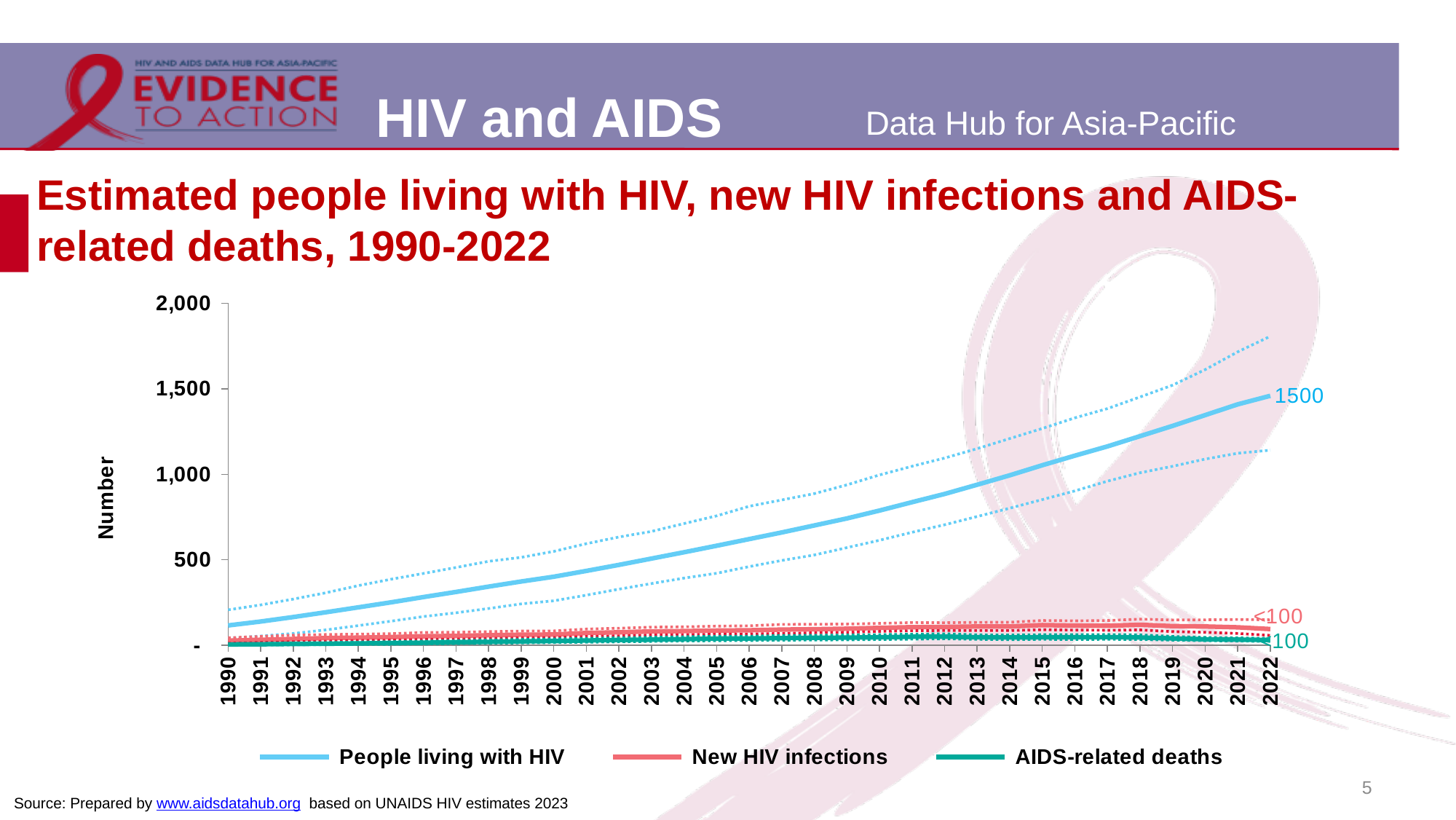
Which is larger in 2022, People living with HIV or AIDS-related deaths? People living with HIV Does the People living with HIV line rise or fall from 1990 to 2022? rise What is the value for People living with HIV in 2022? 1500 Is the value for People living with HIV in 1995 greater or less than 500? less How many series does the legend list? 3 What is the label on the y axis? Number Which series has the highest value in 2022? People living with HIV Is the value for People living with HIV in 2010 greater or less than 500? greater What is the value for New HIV infections in 2022? <100 What type of chart is shown on the slide? line chart